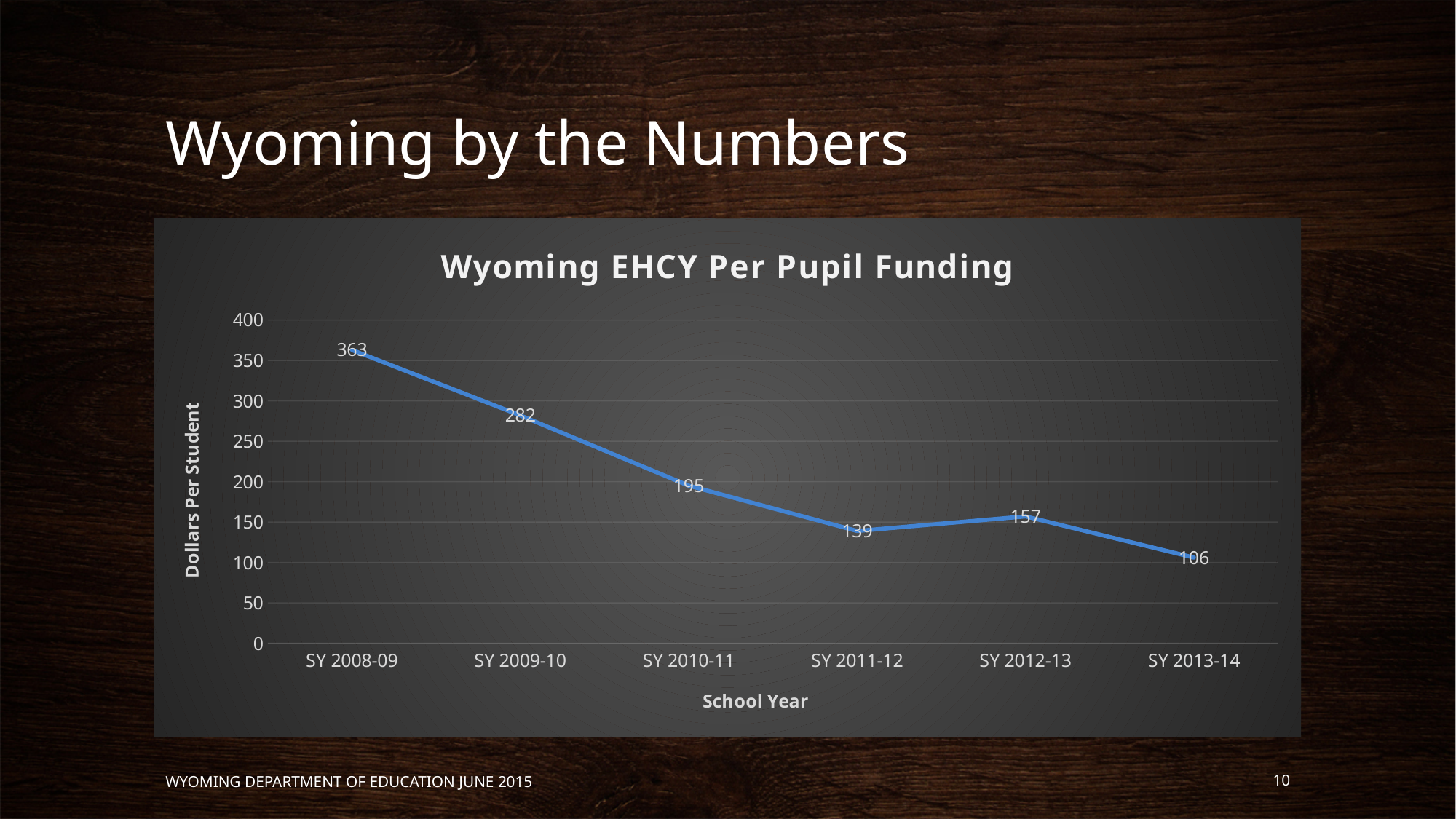
How many school years are plotted on the chart? 6 What is the per pupil funding value for SY 2011-12? 139 What is the difference in per pupil funding between SY 2012-13 and SY 2013-14? 51 What is the per pupil funding value for SY 2008-09? 363 What kind of chart is shown on the slide? line chart Which school year has the lowest per pupil funding? SY 2013-14 Is the per pupil funding for SY 2010-11 greater or less than 200? less What is the title of the chart? Wyoming EHCY Per Pupil Funding What is the per pupil funding value for SY 2013-14? 106 Which is larger, the per pupil funding for SY 2011-12 or SY 2012-13? SY 2012-13 What is the difference in per pupil funding between SY 2008-09 and SY 2009-10? 81 Which school year has the highest per pupil funding? SY 2008-09